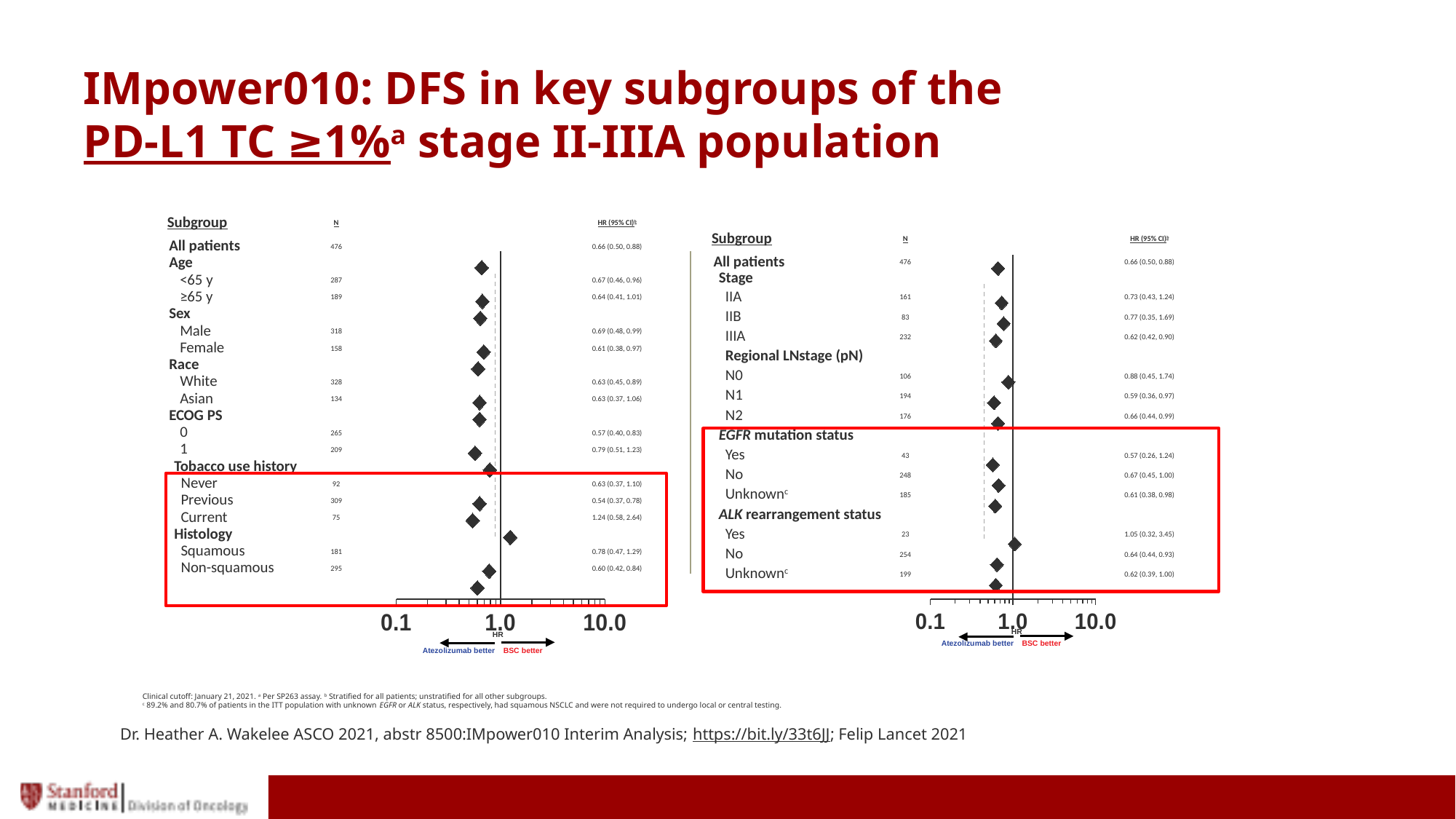
In the right chart, what is N for the N0 regional LN stage subgroup? 106 In the left chart, what is the difference in N between the Male and Female subgroups? 160 What kind of chart is shown on the slide? Forest plot In the right chart, which subgroup has the lowest HR point estimate? EGFR mutation status Yes In the right chart, what is the HR (95% CI) for ALK rearrangement status Yes? 1.05 (0.32, 3.45) In the left chart, which has the larger HR point estimate: ECOG PS 0 or ECOG PS 1? ECOG PS 1 In the right chart, is the HR for the N0 subgroup greater or less than 1.0? less In the left chart, which subgroup has the lowest HR point estimate? Previous (tobacco use history) In the left chart, what is N for the Previous tobacco use subgroup? 309 In the left chart, what is the HR (95% CI) for the Current tobacco use subgroup? 1.24 (0.58, 2.64) In the right chart, which subgroup has the highest HR point estimate? ALK rearrangement status Yes In the left chart, which subgroup has the highest HR point estimate? Current (tobacco use history)